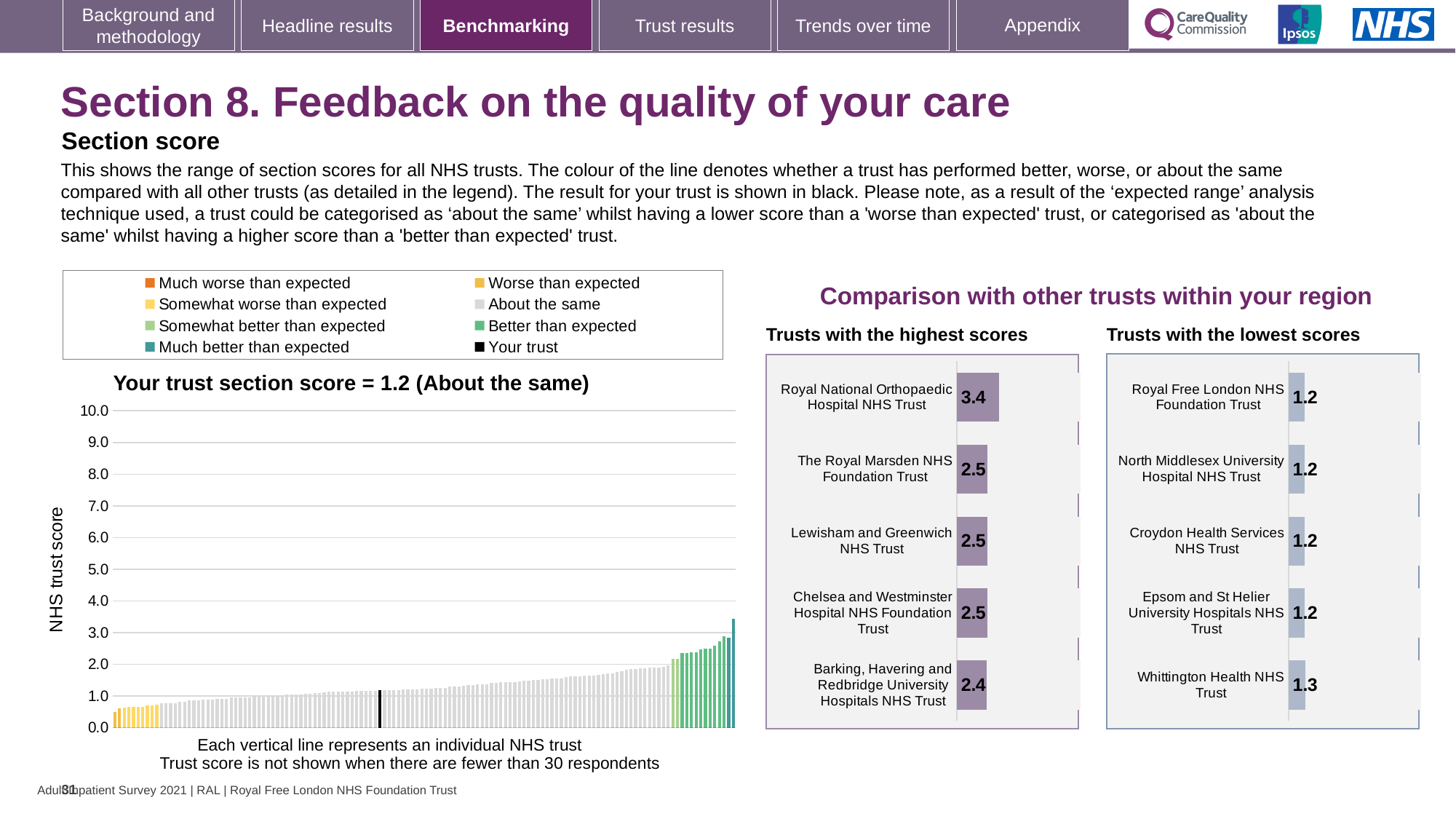
In the 'Your trust section score' chart, is the tallest bar greater or less than 4.0? less In the 'Your trust section score' chart, do the trust scores rise or fall from left to right along the x axis? Rise In the 'Trusts with the highest scores' chart, what is the difference between the scores of Royal National Orthopaedic Hospital NHS Trust and Barking, Havering and Redbridge University Hospitals NHS Trust? 1.0 In the 'Trusts with the highest scores' chart, how many trusts are listed? 5 How many entries does the legend above the 'Your trust section score' chart list? 8 According to the 'Your trust section score' chart title, what is your trust's section score? 1.2 In the 'Trusts with the lowest scores' chart, how many trusts are listed? 5 What kind of chart is the 'Your trust section score' chart? Bar chart In the 'Trusts with the lowest scores' chart, which trust has the highest score? Whittington Health NHS Trust In the 'Trusts with the highest scores' chart, what is the score for Royal National Orthopaedic Hospital NHS Trust? 3.4 In the 'Trusts with the lowest scores' chart, what is the score for Whittington Health NHS Trust? 1.3 In the 'Trusts with the highest scores' chart, which trust has the highest score? Royal National Orthopaedic Hospital NHS Trust